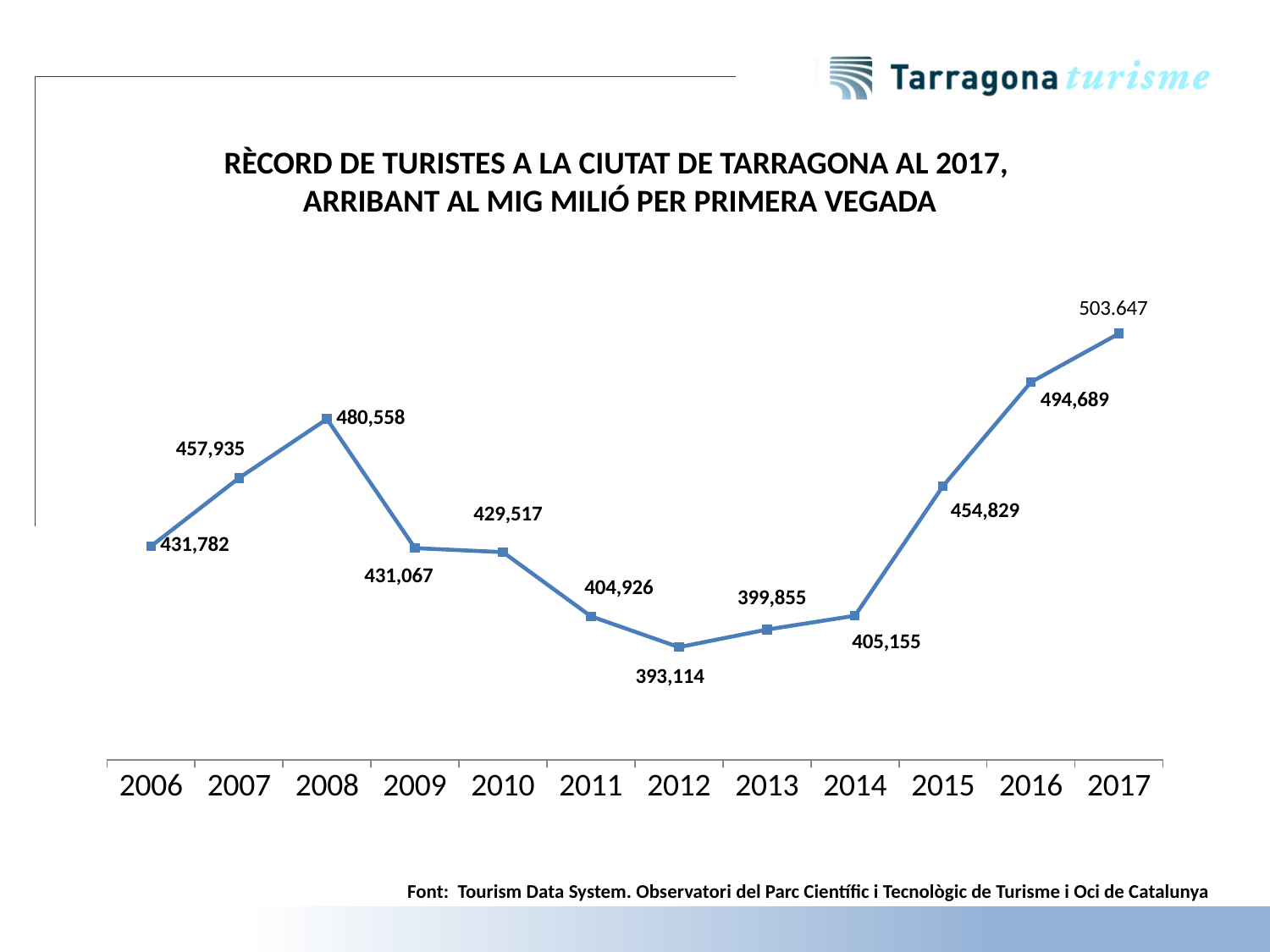
What is the difference between the values for 2014 and 2013? 5,300 What is the value for 2012? 393,114 Do the values rise or fall from 2012 to 2017? rise What is the value for 2008? 480,558 Which year has the lowest value? 2012 Which is larger, the value for 2007 or the value for 2016? 2016 What is the value for 2015? 454,829 What is the difference between the values for 2008 and 2009? 49,491 What kind of chart is shown on the slide? line chart Which year has the highest value? 2017 What is the value for 2017? 503.647 How many years are plotted on the x axis? 12